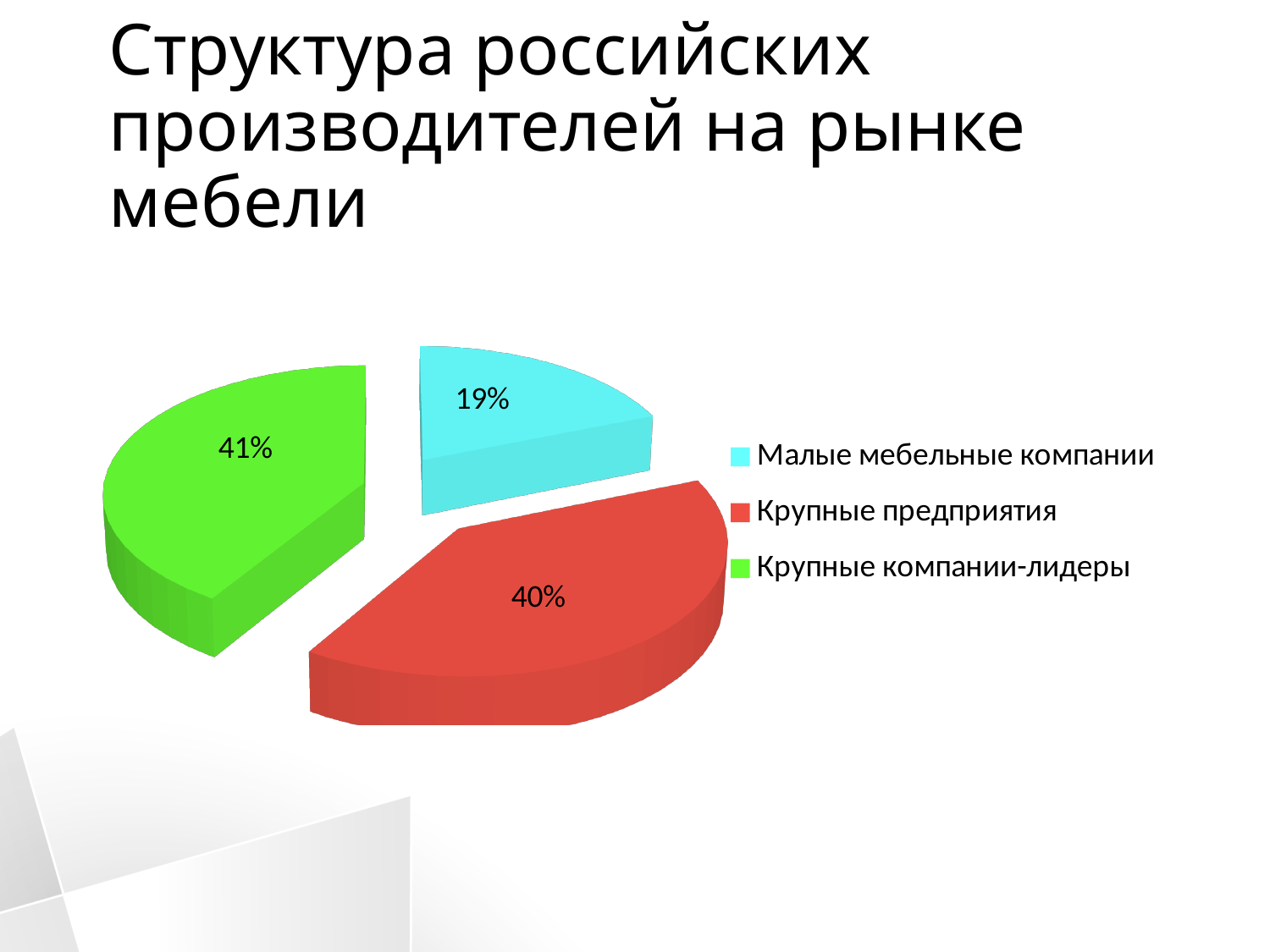
Which category has the smallest slice of the pie? Малые мебельные компании Which is larger: the slice for Крупные предприятия or the slice for Малые мебельные компании? Крупные предприятия What is the difference in percentage points between Крупные компании-лидеры and Крупные предприятия? 1 What share of the pie does Крупные предприятия hold? 40% What type of chart is shown on the slide? Pie chart How many slices does the pie chart have? 3 What colour is the slice for Крупные предприятия? Red What is the title of the slide containing the pie chart? Структура российских производителей на рынке мебели Which category has the largest slice of the pie? Крупные компании-лидеры What share of the pie does Крупные компании-лидеры hold? 41% What is the difference in percentage points between Крупные предприятия and Малые мебельные компании? 21 What share of the pie does Малые мебельные компании hold? 19%